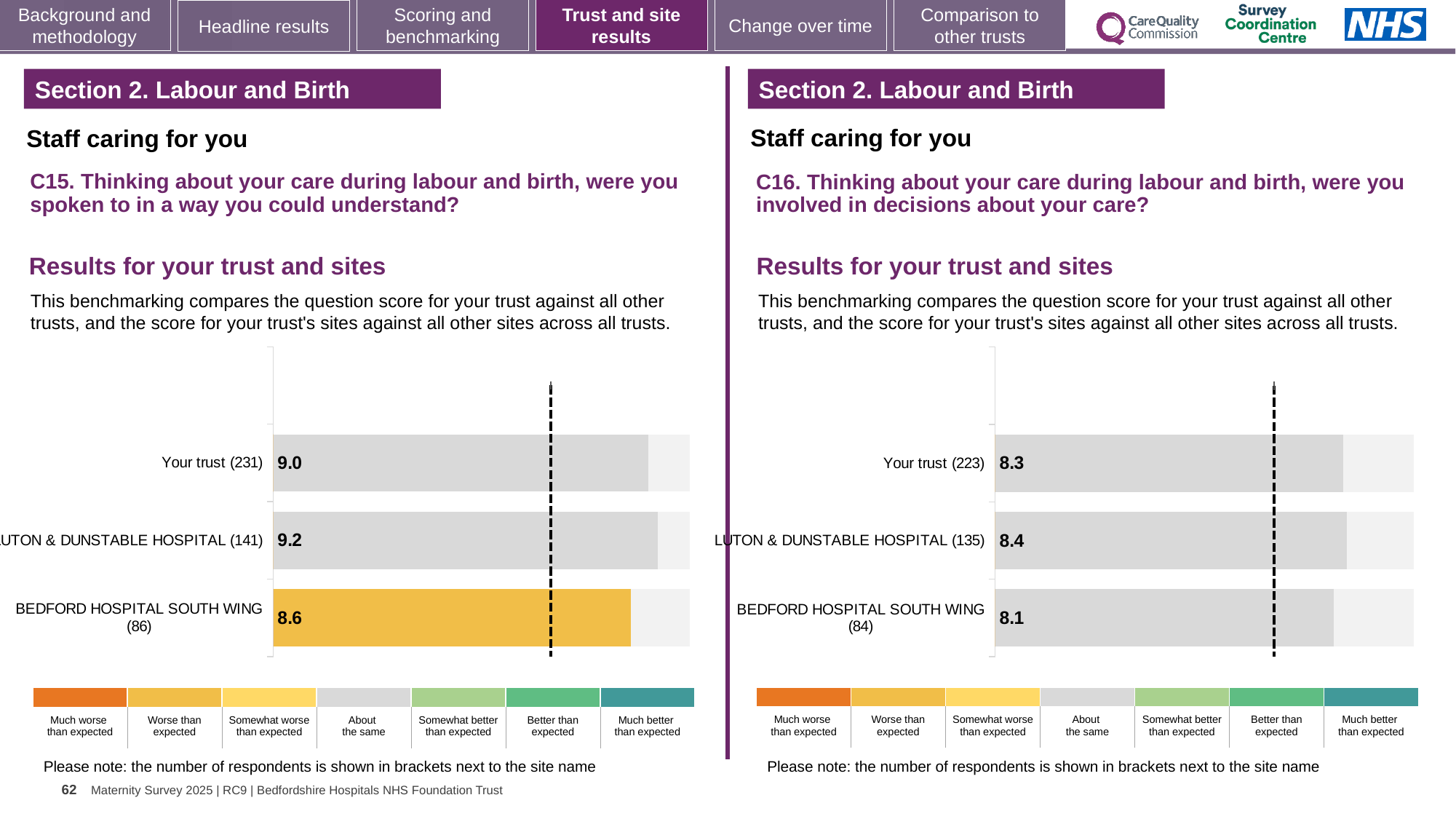
In the right chart (C16), what is the score for Your trust? 8.3 In the left chart (C15), which has the larger score: Your trust or Bedford Hospital South Wing? Your trust In the right chart (C16), which site or trust has the lowest score? Bedford Hospital South Wing How many bars are plotted in the right chart (C16)? 3 In the left chart (C15), which site or trust has the highest score? Luton & Dunstable Hospital In the left chart (C15), how many respondents are shown in brackets for Bedford Hospital South Wing? 86 In the right chart (C16), what is the difference between the scores for Your trust and Bedford Hospital South Wing? 0.2 In the right chart (C16), what is the score for Luton & Dunstable Hospital? 8.4 What type of chart is used on the left (C15)? Bar chart In the left chart (C15), what is the score for Bedford Hospital South Wing? 8.6 In the left chart (C15), what is the score for Your trust? 9.0 In the left chart (C15), what is the difference between the scores for Luton & Dunstable Hospital and Bedford Hospital South Wing? 0.6